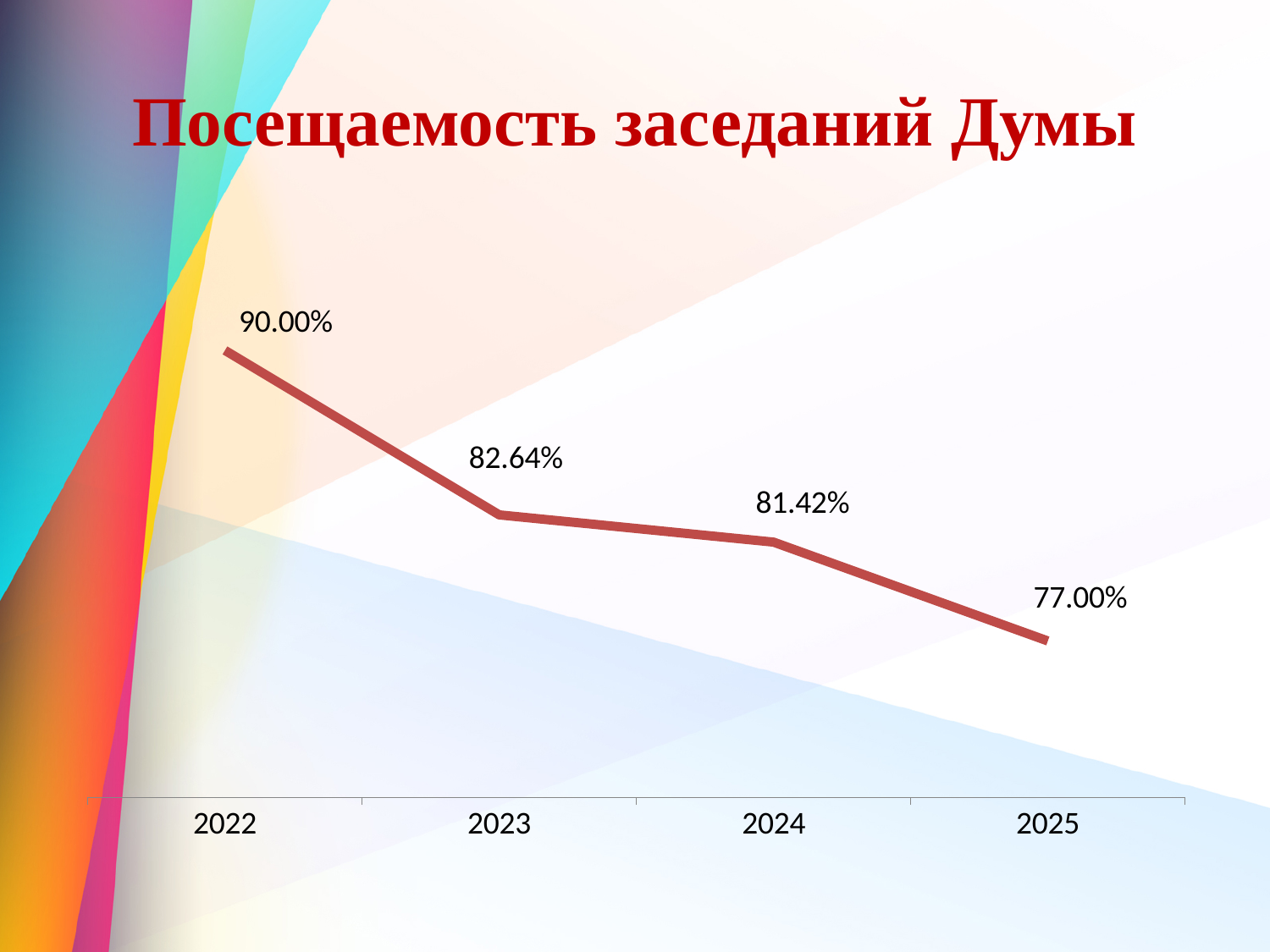
What is the difference between the 2023 and 2024 values? 1.22% How many years are plotted on the chart? 4 Which is larger, the value for 2023 or the value for 2025? 2023 Do the values rise or fall from 2022 to 2025? Fall Which year has the highest attendance? 2022 What is the attendance value for 2024? 81.42% Which year has the lowest attendance? 2025 What is the attendance value for 2023? 82.64% What kind of chart is shown on the slide? Line chart What is the difference between the 2022 and 2025 values? 13.00% What is the attendance value for 2025? 77.00% What is the attendance value for 2022? 90.00%